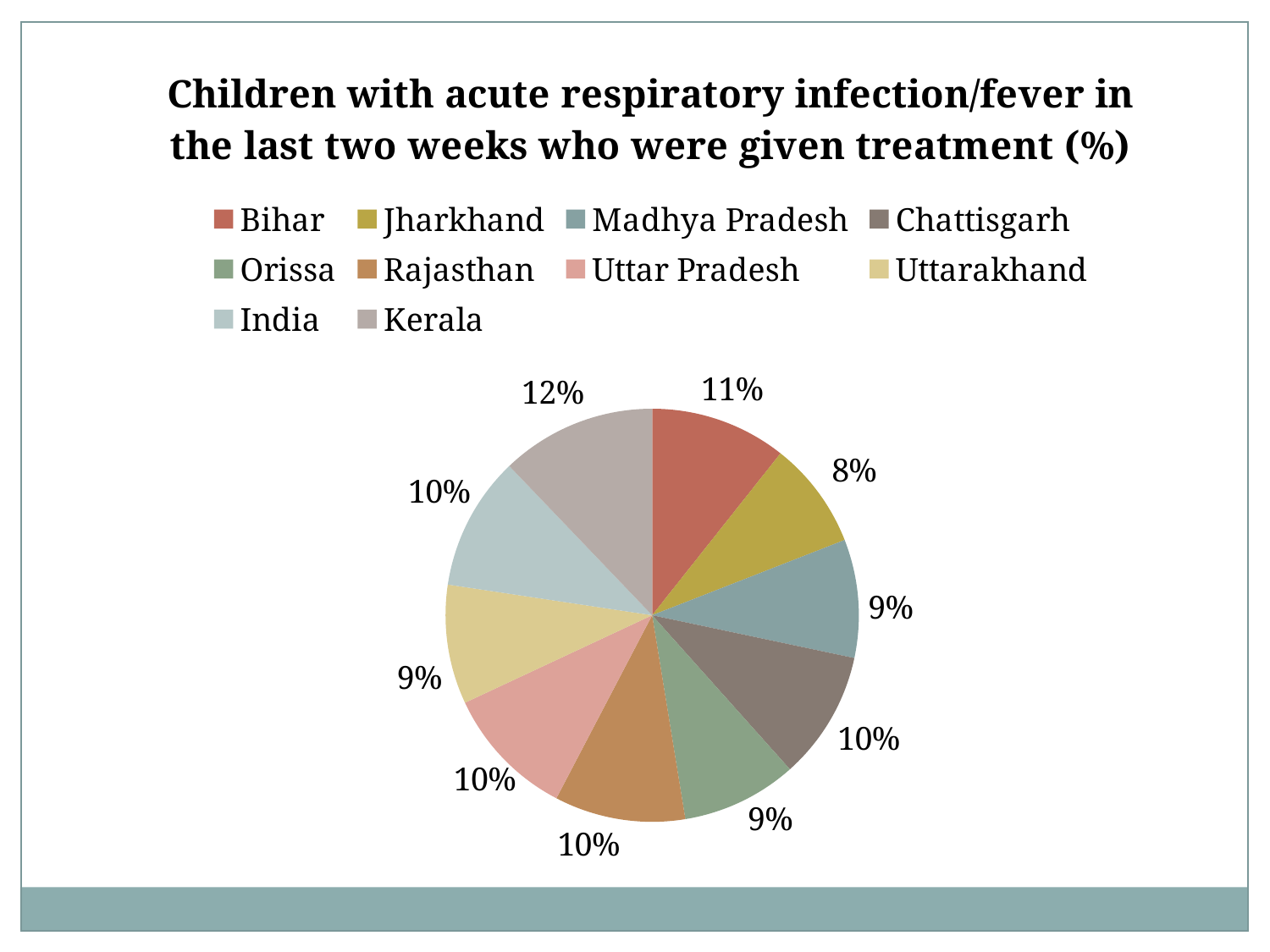
What is the difference in percentage points between the Kerala slice and the Jharkhand slice? 4 What is the title of the chart? Children with acute respiratory infection/fever in the last two weeks who were given treatment (%) What share of the pie does Rajasthan represent? 10% Which category has the smallest slice of the pie? Jharkhand What share of the pie does Jharkhand represent? 8% What share of the pie does Kerala represent? 12% What kind of chart is shown on the slide? pie chart Which slice is larger, Bihar or Jharkhand? Bihar Which category has the largest slice of the pie? Kerala How many slices does the pie chart have? 10